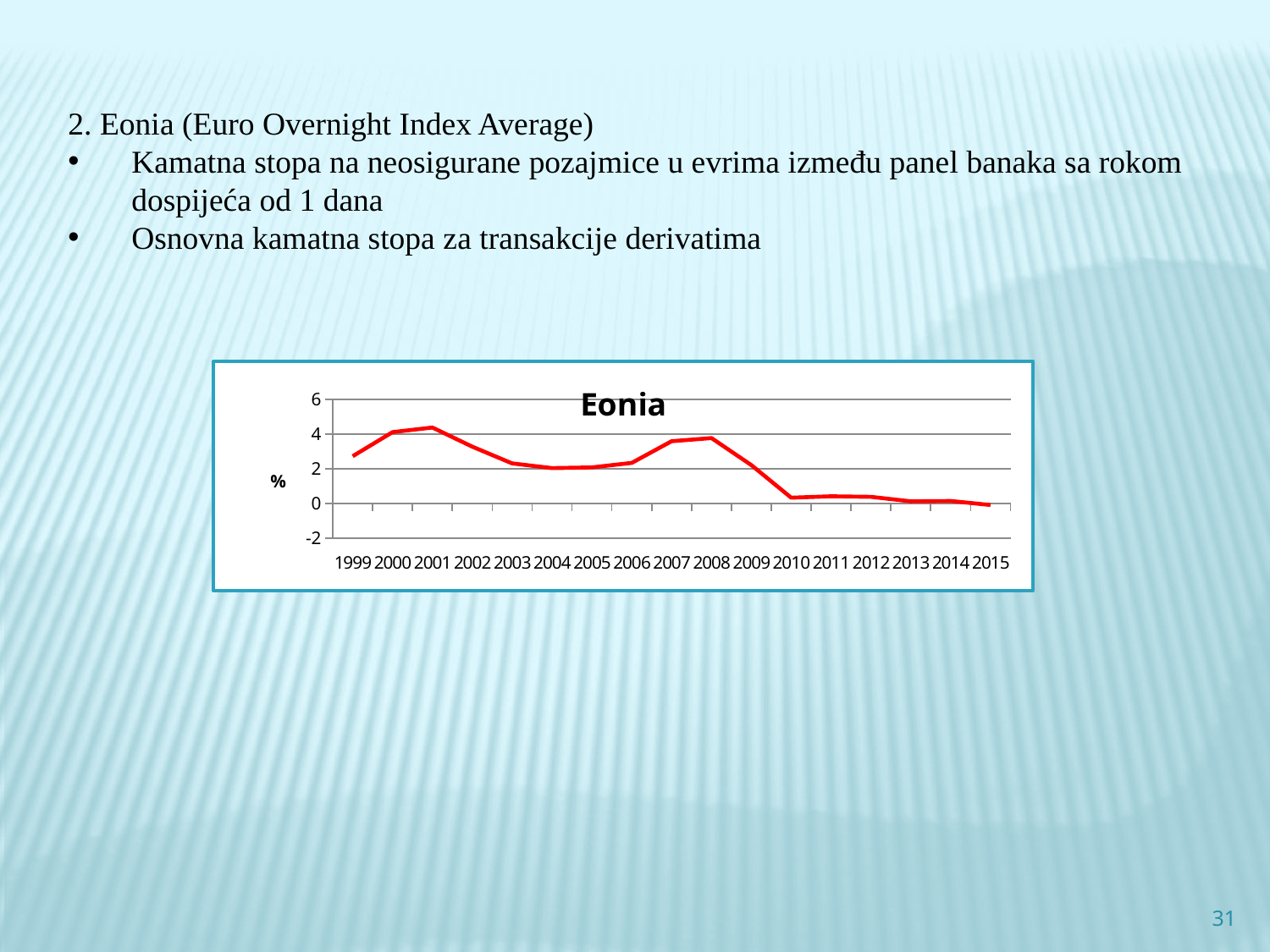
Is the value for 2004 greater or less than 4? less Is the value for 2008 greater or less than 2? greater In which year is the Eonia rate lowest? 2015 Which year has the larger Eonia value, 2001 or 2010? 2001 What is the title of the chart? Eonia What kind of chart is shown on the slide? line chart What label is shown on the vertical axis of the chart? % In which year is the Eonia rate highest? 2001 Is the value for 2010 greater or less than 2? less How many years are shown on the x axis of the chart? 17 Does the Eonia rate rise or fall from 2008 to 2015? fall